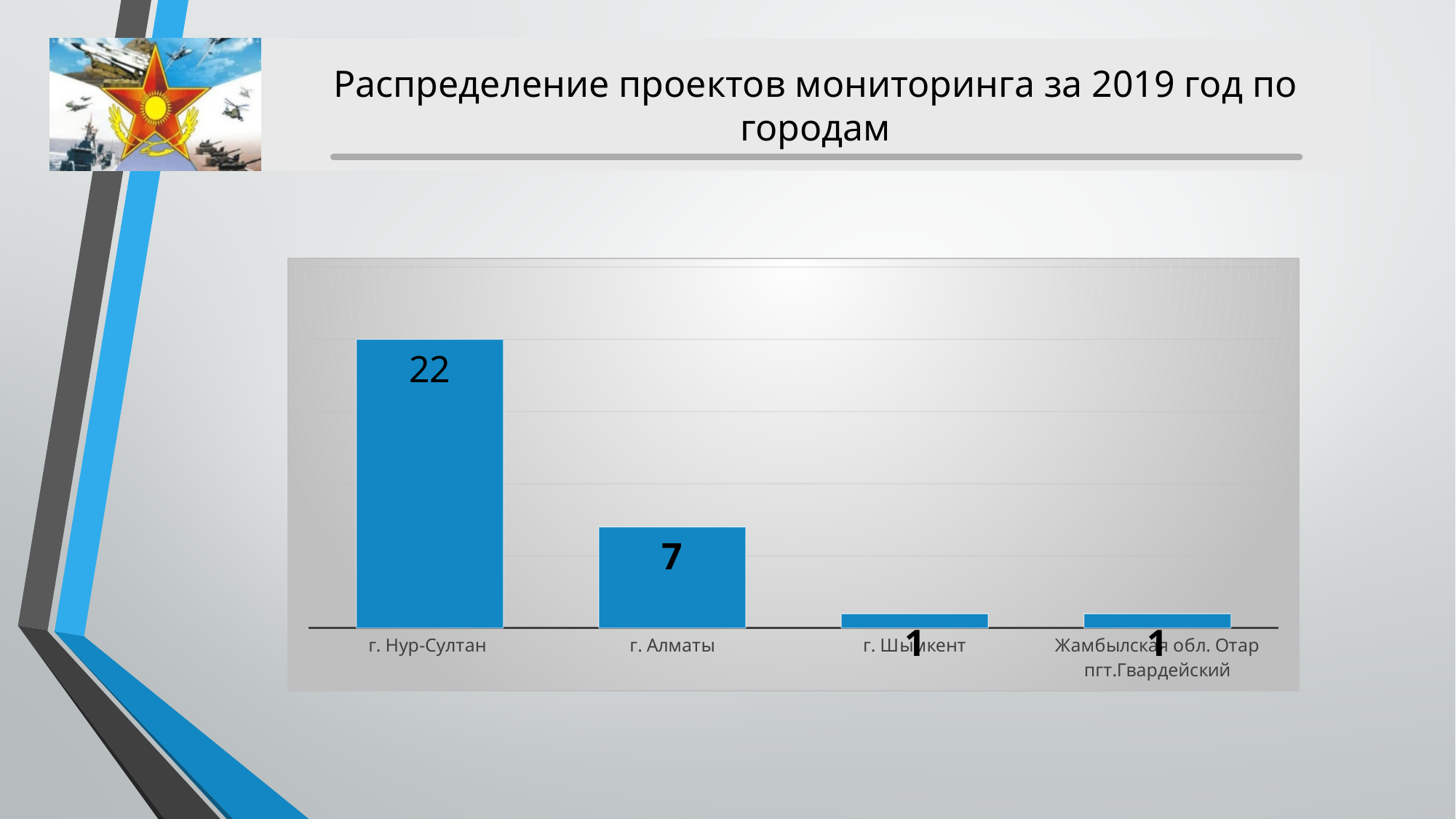
Which is larger, the value for г. Нур-Султан or the value for г. Алматы? г. Нур-Султан Which category has the highest value? г. Нур-Султан What is the difference between the values for г. Нур-Султан and г. Алматы? 15 How many categories are shown on the chart? 4 What is the title of the slide? Распределение проектов мониторинга за 2019 год по городам What is the value for Жамбылская обл. Отар пгт.Гвардейский? 1 What is the value for г. Нур-Султан? 22 What is the value for г. Шымкент? 1 What kind of chart is shown on the slide? bar chart What is the difference between the values for г. Алматы and г. Шымкент? 6 Do the values rise or fall from left to right along the x axis? fall What is the value for г. Алматы? 7